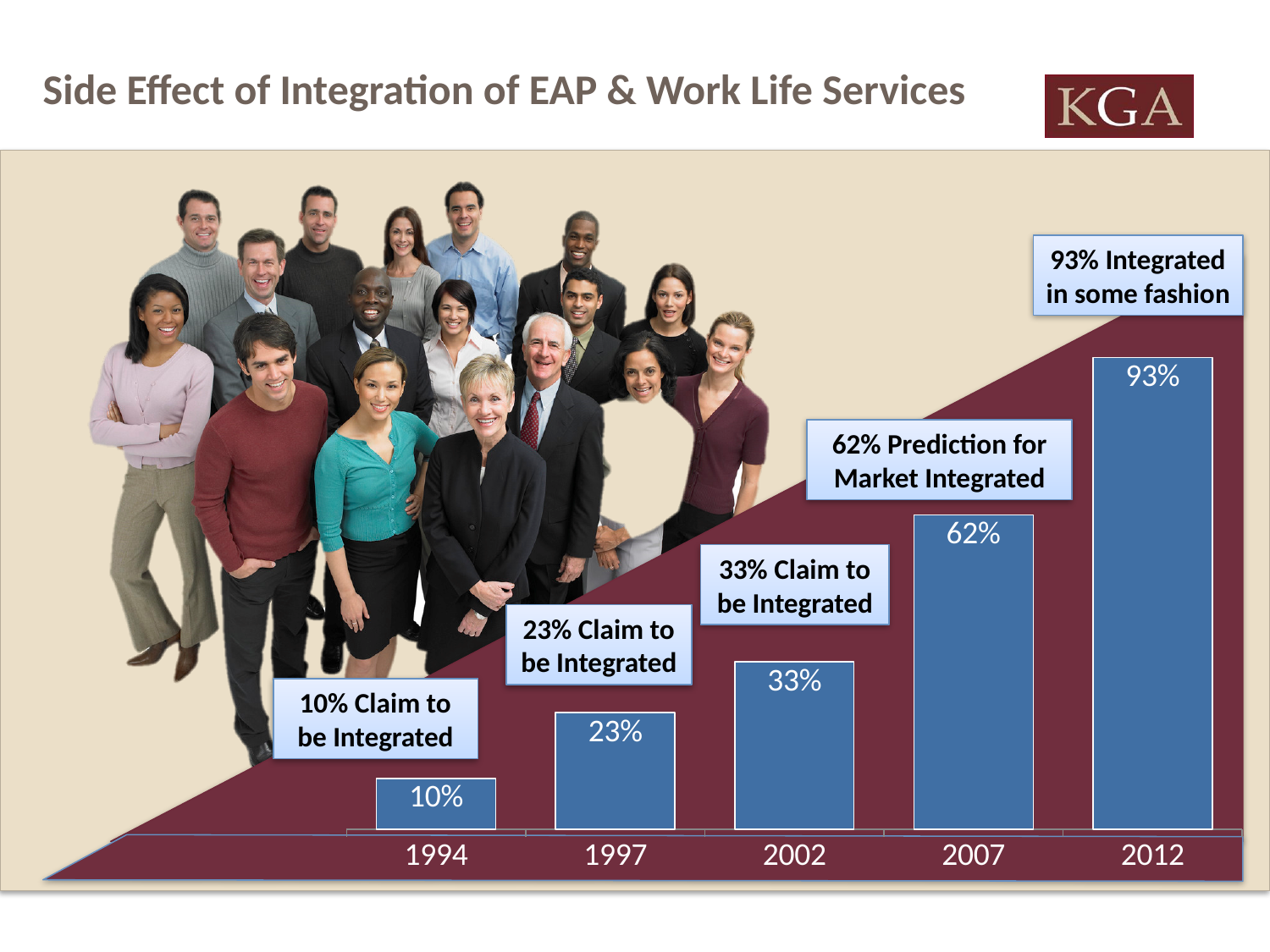
Which is larger, the value for 2002 or the value for 1997? 2002 What is the value for 2002? 33% What is the value for 1994? 10% How many years are shown on the x axis? 5 Which year has the highest value? 2012 What does the callout above the 2007 bar say? 62% Prediction for Market Integrated Which year has the lowest value? 1994 What is the value for 2007? 62% What is the difference between the values for 1997 and 1994? 13% What kind of chart is shown on the slide? Bar chart What is the difference between the values for 2012 and 2007? 31% Do the values rise or fall from 1994 to 2012? Rise